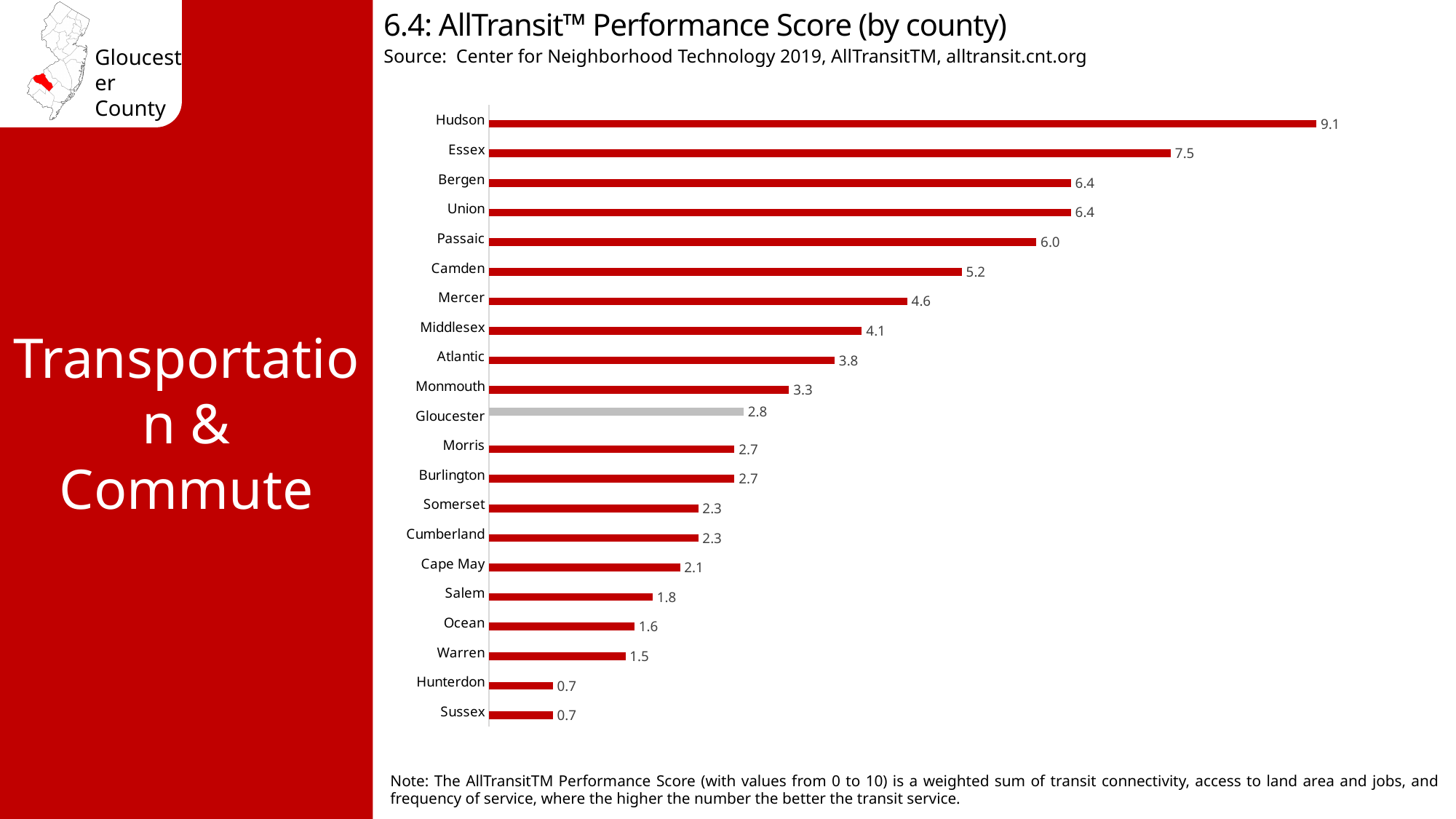
What is the AllTransit Performance Score for Warren? 1.5 Which has a higher AllTransit Performance Score, Mercer or Middlesex? Mercer Which county has the highest AllTransit Performance Score? Hudson What kind of chart is shown on the slide? Bar chart How many counties are shown in the chart? 21 What is the AllTransit Performance Score for Camden? 5.2 What is the title of the chart? 6.4: AllTransit™ Performance Score (by county) What is the difference between Essex's score and Bergen's score? 1.1 Which has a higher AllTransit Performance Score, Monmouth or Gloucester? Monmouth What is the AllTransit Performance Score for Gloucester County? 2.8 Which county's bar is shown in grey rather than red? Gloucester What is the difference between Hudson's score and Gloucester's score? 6.3